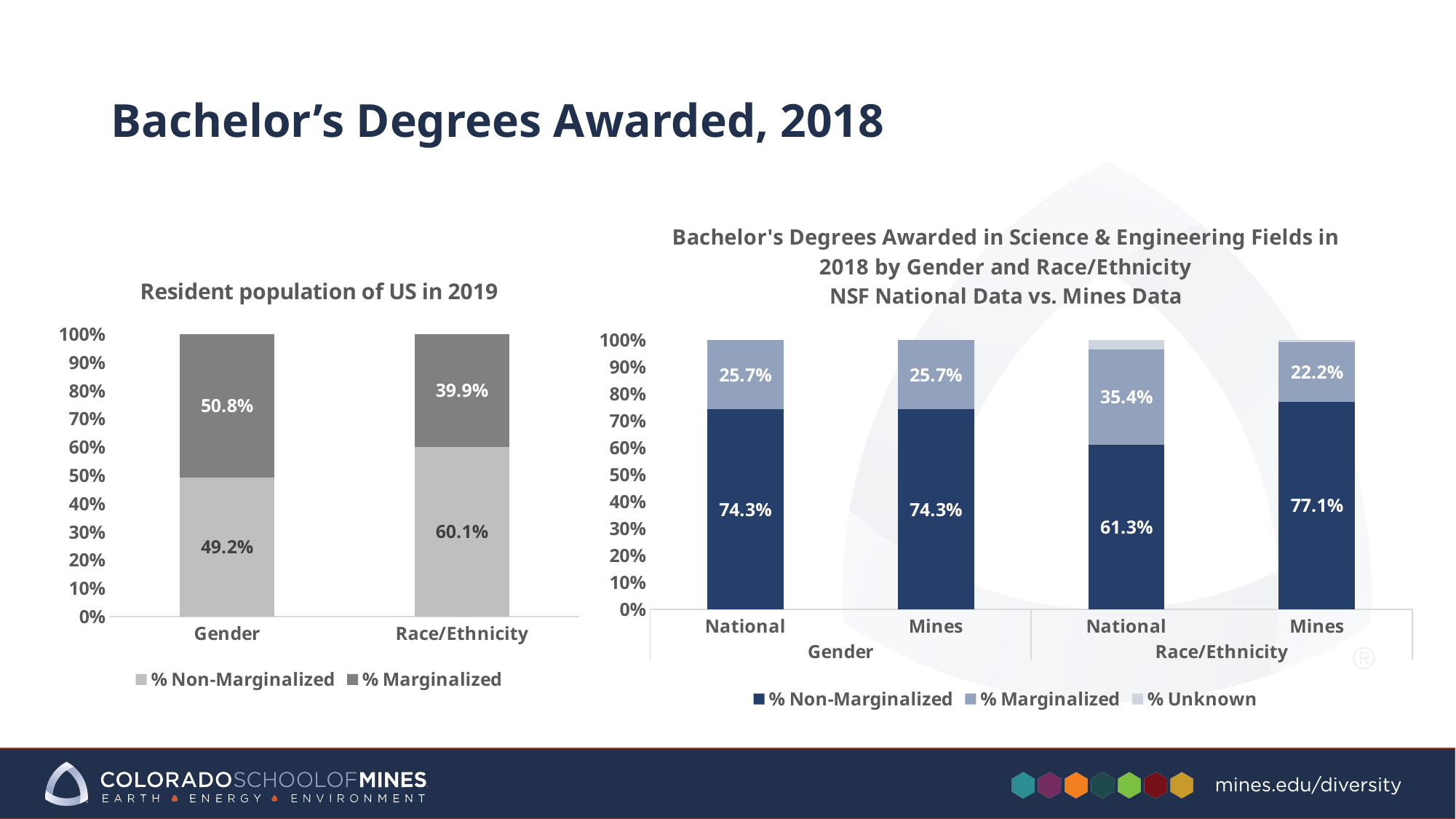
In the 'Resident population of US in 2019' chart, what is the difference between the % Non-Marginalized values for Race/Ethnicity and Gender? 10.9% In the right-hand chart (NSF National Data vs. Mines Data), which bar has the highest % Non-Marginalized value? Mines (Race/Ethnicity) In the right-hand chart (NSF National Data vs. Mines Data), how many series does the legend list? 3 In the 'Resident population of US in 2019' chart, what is the % Marginalized value for Race/Ethnicity? 39.9% In the right-hand chart (NSF National Data vs. Mines Data), what is the % Marginalized value for the Mines bar under Race/Ethnicity? 22.2% In the right-hand chart (NSF National Data vs. Mines Data), which bar has the lowest % Non-Marginalized value? National (Race/Ethnicity) In the 'Resident population of US in 2019' chart, what is the % Non-Marginalized value for Gender? 49.2% In the right-hand chart (NSF National Data vs. Mines Data), how many bars are plotted? 4 In the right-hand chart (NSF National Data vs. Mines Data), what is the % Non-Marginalized value for the National bar under Race/Ethnicity? 61.3% In the right-hand chart (NSF National Data vs. Mines Data), what is the difference between the % Marginalized values for National and Mines under Race/Ethnicity? 13.2% In the 'Resident population of US in 2019' chart, how many series does the legend list? 2 What type of chart is the 'Resident population of US in 2019' chart? Stacked bar chart